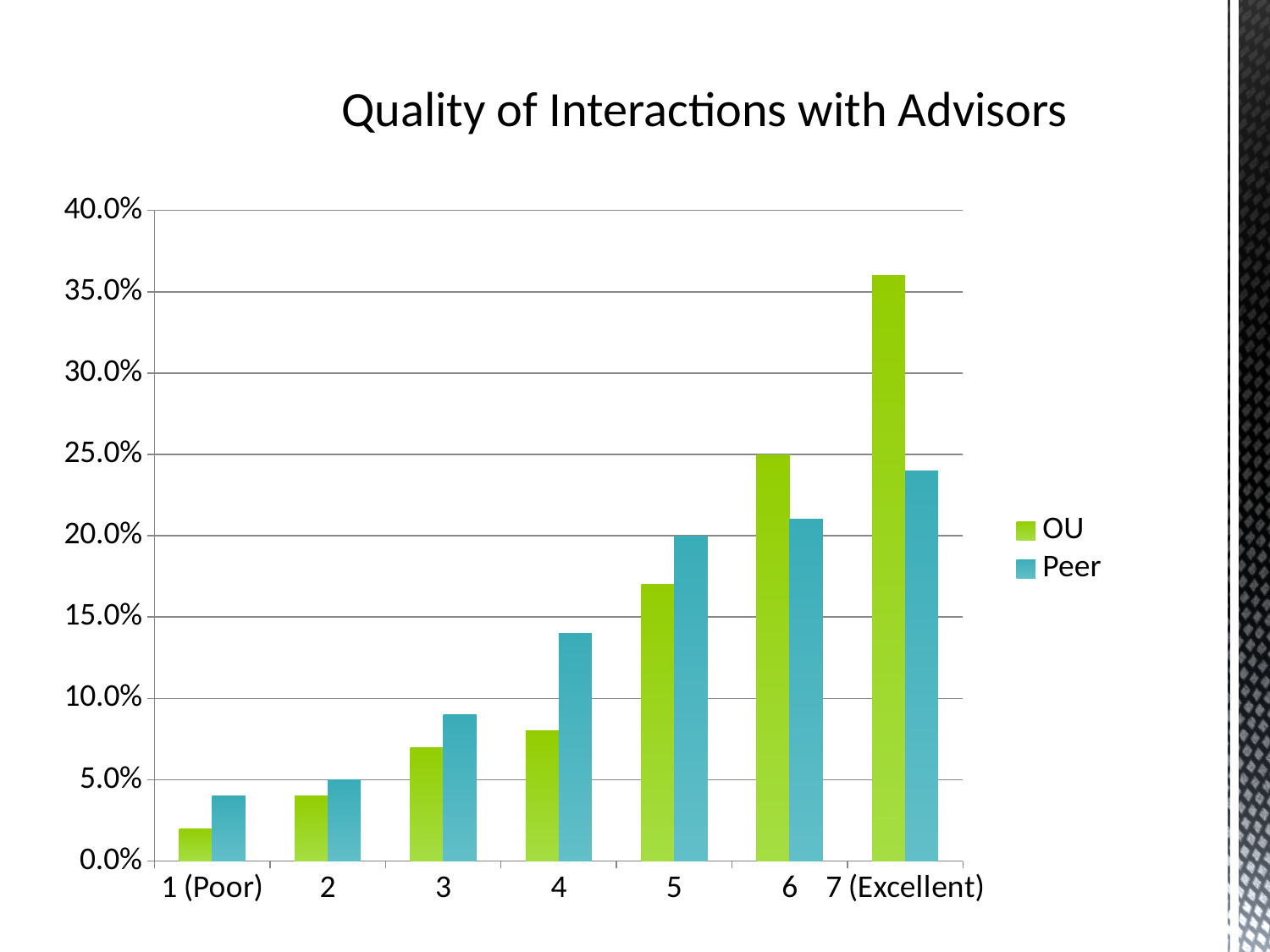
What kind of chart is shown on the slide? bar chart At rating 4, which series has the larger value, OU or Peer? Peer Which rating category has the highest Peer value? 7 (Excellent) How many rating categories are shown on the x axis? 7 Is the OU value for 7 (Excellent) greater or less than 35.0%? greater Which rating category has the lowest OU value? 1 (Poor) How many series does the legend list? 2 Do the OU values rise or fall as the rating goes from 1 (Poor) to 7 (Excellent)? rise At rating 7 (Excellent), which series has the larger value, OU or Peer? OU Is the Peer value for rating 4 greater or less than 15.0%? less Which rating category has the highest OU value? 7 (Excellent) What is the title of the chart? Quality of Interactions with Advisors